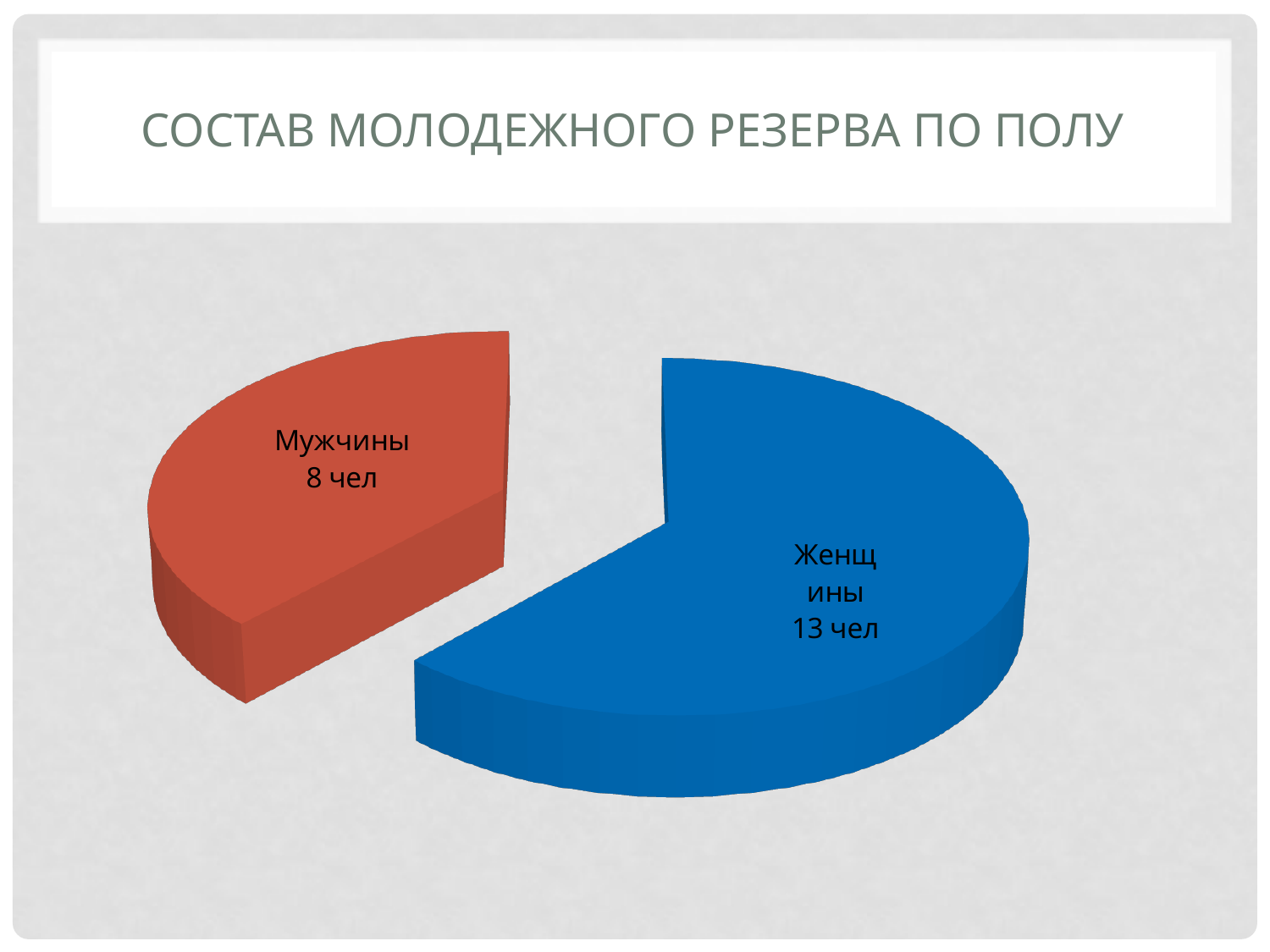
What is the title of the slide? Состав молодежного резерва по полу How many people are in the Женщины slice? 13 чел What kind of chart is shown on the slide? Pie chart How many slices does the pie chart have? 2 Which category has the smallest slice? Мужчины Which category has the largest slice? Женщины Which is larger, the Мужчины slice or the Женщины slice? Женщины How many people are in the Мужчины slice? 8 чел What is the total number of people represented in the pie chart? 21 чел What is the difference between the number of Женщины and Мужчины? 5 чел What colour is the Мужчины slice? Red